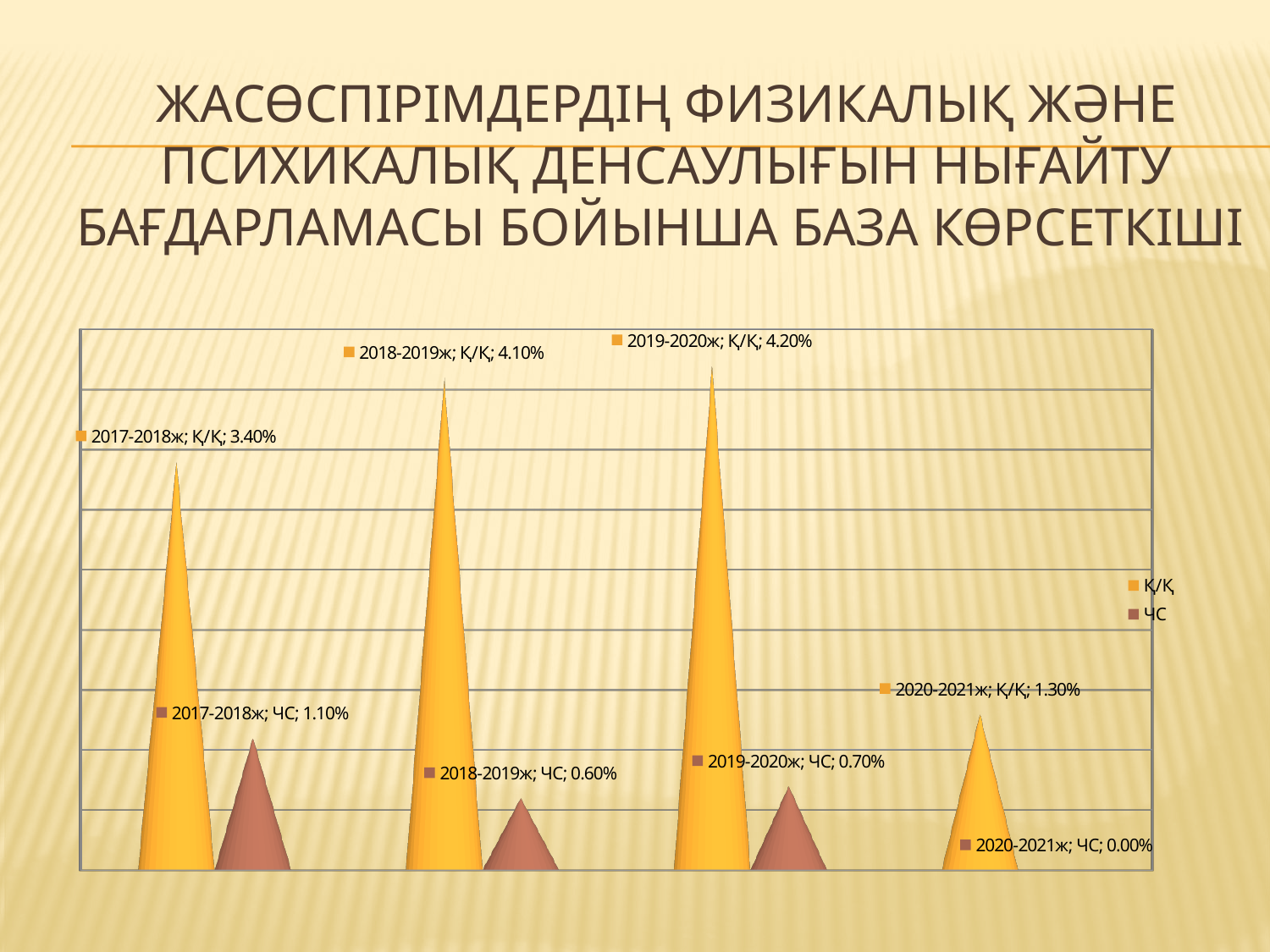
How many series does the legend list? 2 How many year categories are shown on the chart? 4 What is the difference between the Қ/Қ values for 2019-2020ж and 2020-2021ж? 2.90% Which year has the lowest ЧС value? 2020-2021ж Which series is shown in brown in the legend? ЧС What is the Қ/Қ value for 2020-2021ж? 1.30% What is the ЧС value for 2019-2020ж? 0.70% Which year has the highest Қ/Қ value? 2019-2020ж What is the Қ/Қ value for 2017-2018ж? 3.40% Which is larger, the ЧС value for 2017-2018ж or for 2018-2019ж? 2017-2018ж What is the ЧС value for 2020-2021ж? 0.00% What kind of chart is shown on the slide? Bar chart